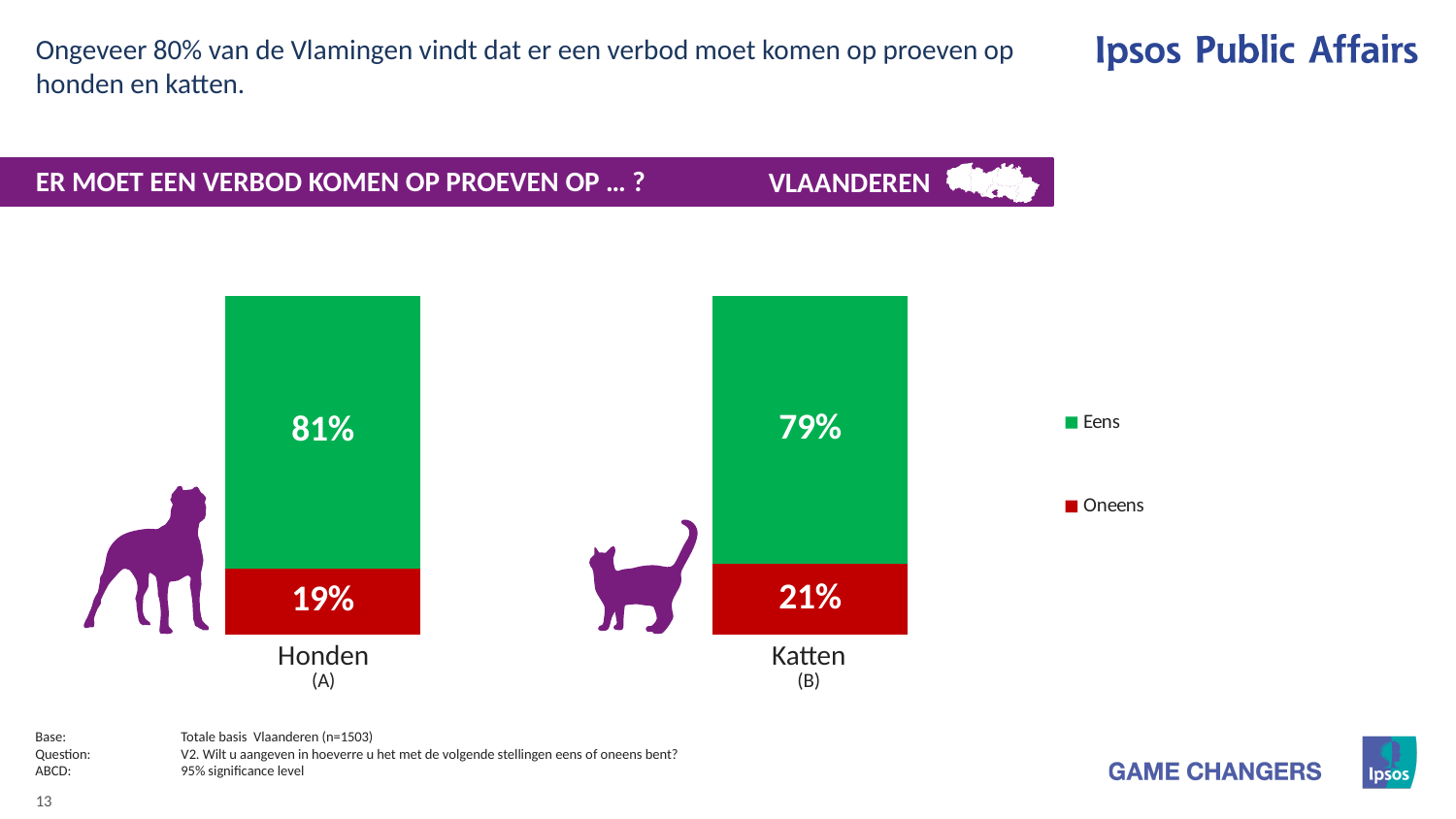
How many series does the legend list? 2 What is the total of the stacked bar for Katten? 100% What is the Oneens value for Honden? 19% Which category has the higher Eens share, Honden or Katten? Honden What percentage of respondents disagree (Oneens) with a ban on testing on cats (Katten)? 21% Which category has the highest Oneens share? Katten How many categories are shown on the x axis? 2 What kind of chart is shown on the slide? Stacked bar chart What percentage of respondents agree (Eens) with a ban on testing on dogs (Honden)? 81% What is the difference between the Eens values for Honden and Katten? 2% Which colour represents Oneens in the legend? Red What is the Eens value for Katten? 79%